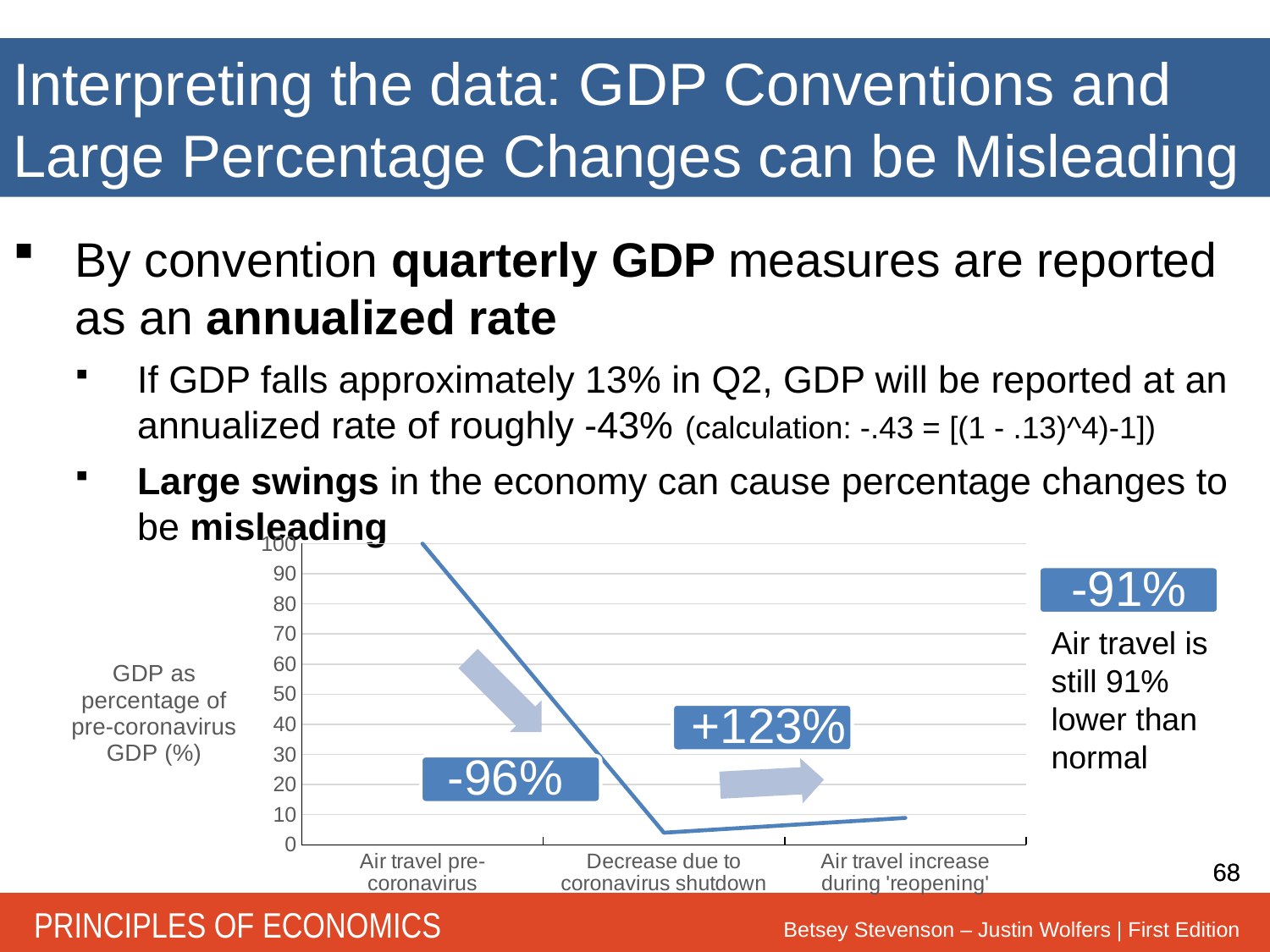
Which is larger: the value for 'Decrease due to coronavirus shutdown' or the value for 'Air travel increase during 'reopening''? Air travel increase during 'reopening' Does the line fall or rise between 'Air travel pre-coronavirus' and 'Decrease due to coronavirus shutdown'? fall What percentage change is shown in the annotation between the first and second points of the chart? -96% What kind of chart is shown on the slide? line chart Which category has the lowest value in the chart? Decrease due to coronavirus shutdown Which category has the highest value in the chart? Air travel pre-coronavirus Is the value for 'Air travel increase during 'reopening'' greater or less than 20? less Which is larger: the value for 'Air travel pre-coronavirus' or the value for 'Air travel increase during 'reopening''? Air travel pre-coronavirus How many categories are plotted along the x axis of the chart? 3 What is the value for 'Air travel pre-coronavirus' in the chart? 100 Is the value for 'Decrease due to coronavirus shutdown' greater or less than 10? less What is the y-axis label of the chart? GDP as percentage of pre-coronavirus GDP (%)